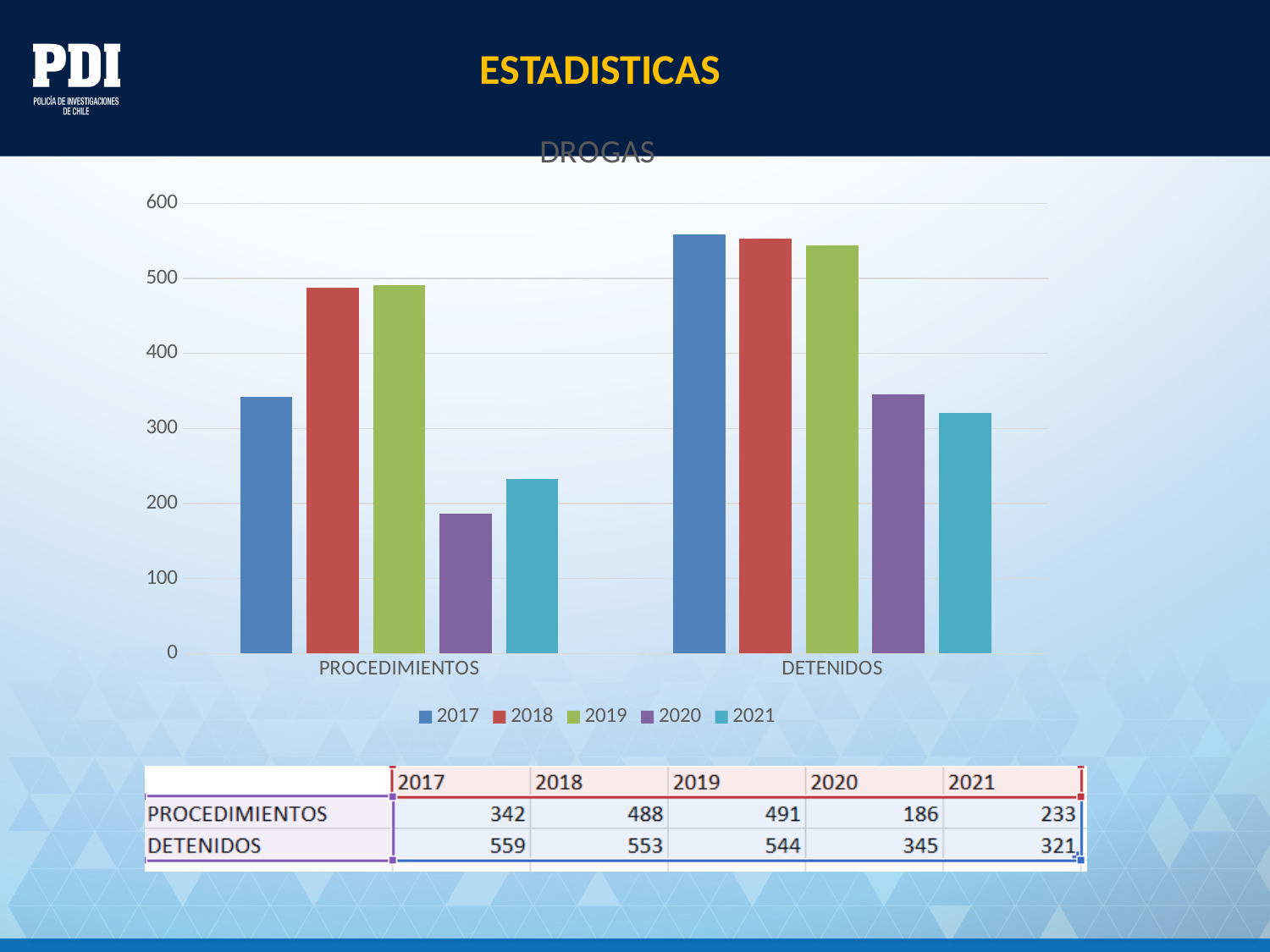
How many series does the chart legend list? 5 What is the difference between DETENIDOS in 2017 and DETENIDOS in 2021? 238 What is the value for PROCEDIMIENTOS in 2021? 233 Which year has the lowest value for PROCEDIMIENTOS? 2020 Which year has the highest value for DETENIDOS? 2017 How many categories are shown on the x axis of the chart? 2 What is the title of the chart? DROGAS Is the value for DETENIDOS in 2019 greater or less than 500? greater Which is larger, PROCEDIMIENTOS in 2017 or PROCEDIMIENTOS in 2018? PROCEDIMIENTOS in 2018 What kind of chart is shown on the slide? bar chart What is the value for PROCEDIMIENTOS in 2019? 491 What is the value for DETENIDOS in 2020? 345